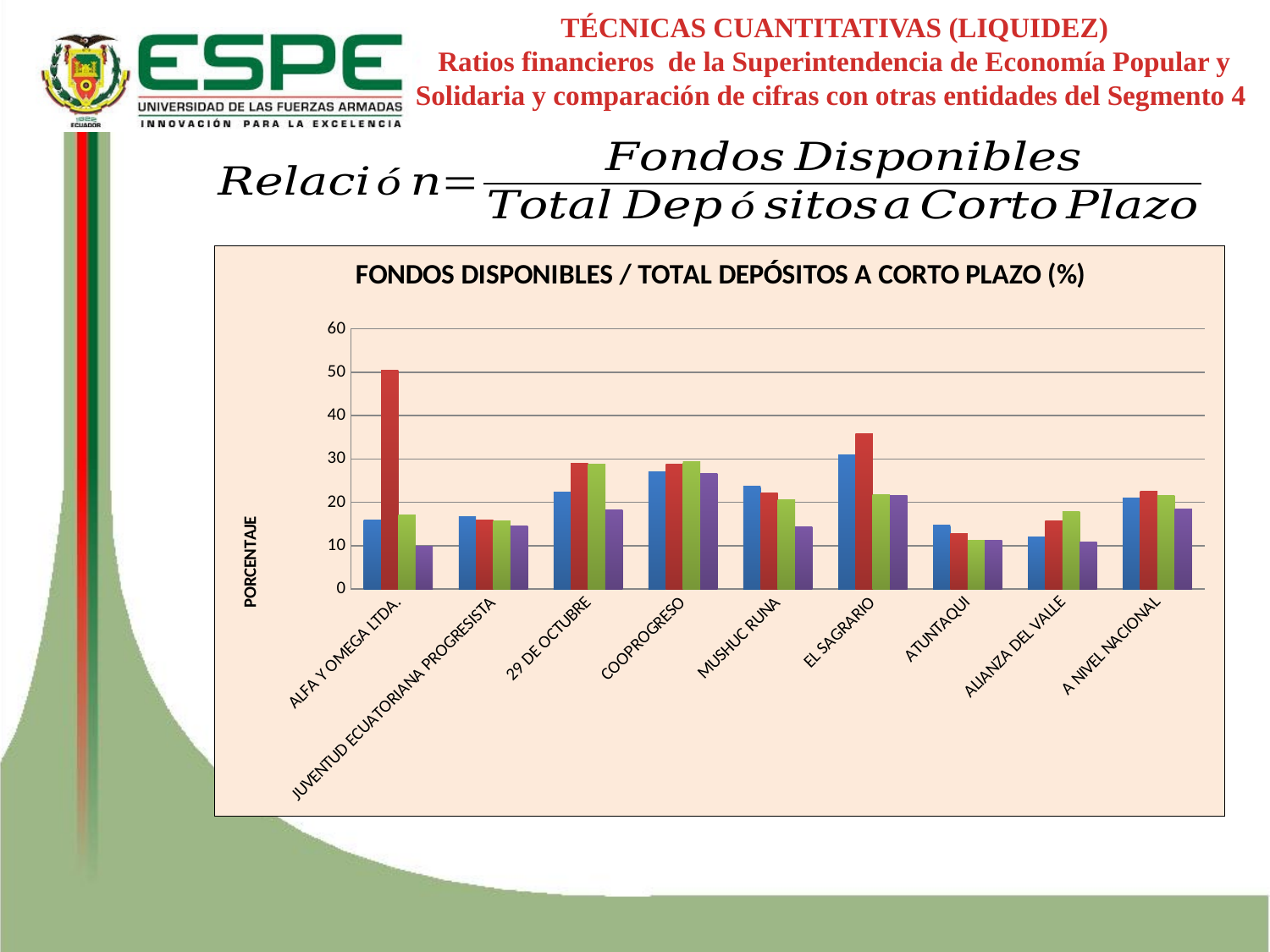
What is the title of the chart? FONDOS DISPONIBLES / TOTAL DEPÓSITOS A CORTO PLAZO (%) What kind of chart is shown on the slide? bar chart Which has the larger blue bar, EL SAGRARIO or ATUNTAQUI? EL SAGRARIO Is the value of the red bar for ALFA Y OMEGA LTDA. greater or less than 40? greater Is the value of the purple bar for 29 DE OCTUBRE greater or less than 20? less How many categories are shown along the x axis of the chart? 9 Which category contains the tallest bar in the chart? ALFA Y OMEGA LTDA. Is the value of the red bar for EL SAGRARIO greater or less than 30? greater Which has the larger red bar, ALFA Y OMEGA LTDA. or EL SAGRARIO? ALFA Y OMEGA LTDA. What is the label on the vertical axis of the chart? PORCENTAJE